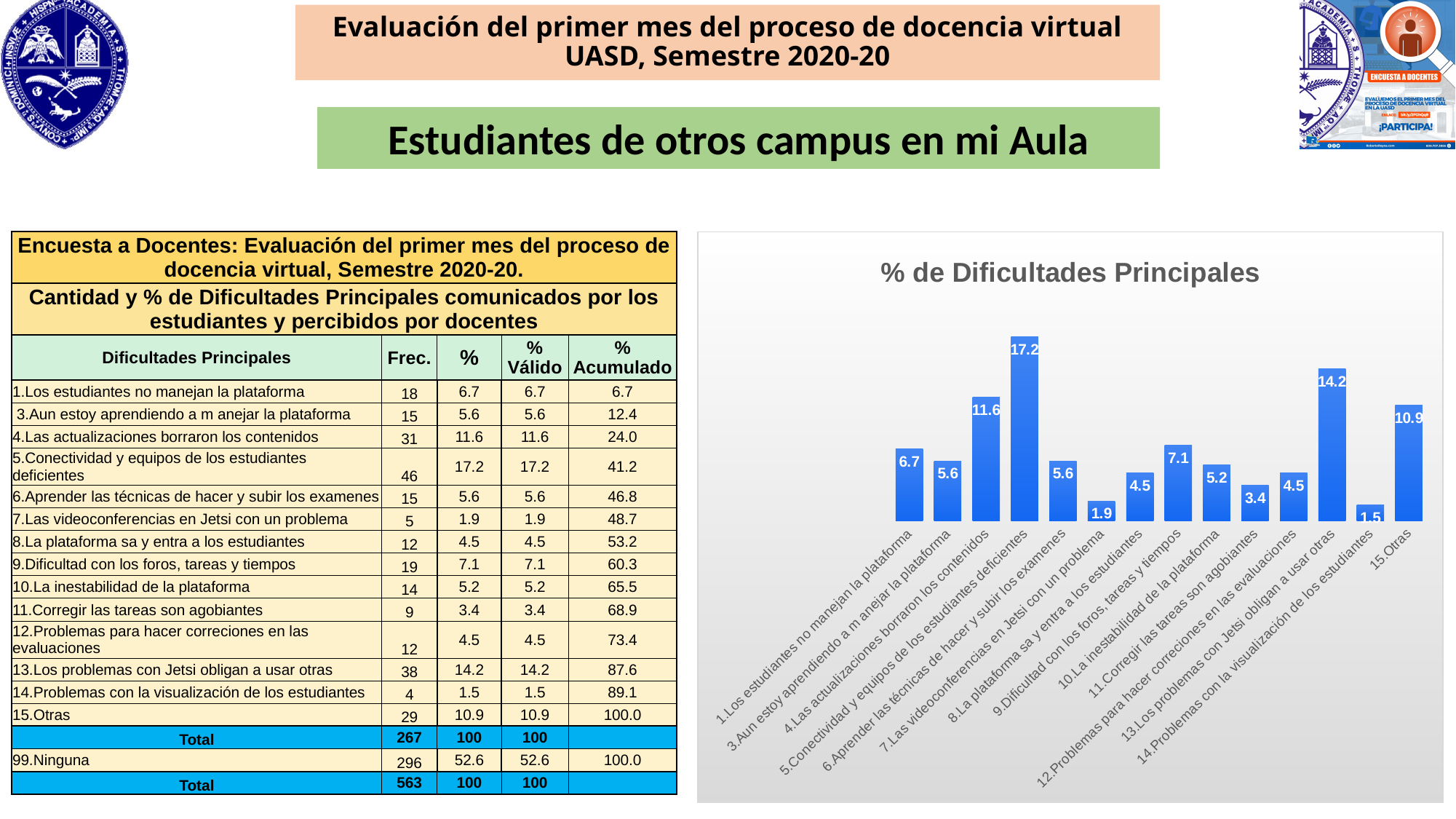
What is the title of the chart? % de Dificultades Principales What type of chart is shown on the slide? bar chart What is the value for '15.Otras' in the chart? 10.9 What is the value for '13.Los problemas con Jetsi obligan a usar otras' in the chart? 14.2 What is the difference between the values for '5.Conectividad y equipos de los estudiantes deficientes' and '13.Los problemas con Jetsi obligan a usar otras'? 3.0 Which category has the highest value in the chart? 5.Conectividad y equipos de los estudiantes deficientes Which is larger: the value for '4.Las actualizaciones borraron los contenidos' or the value for '15.Otras'? 4.Las actualizaciones borraron los contenidos How many bars does the chart have? 14 What is the difference between the values for '9.Dificultad con los foros, tareas y tiempos' and '11.Corregir las tareas son agobiantes'? 3.7 What is the value for '7.Las videoconferencias en Jetsi con un problema' in the chart? 1.9 Which category has the lowest value in the chart? 14.Problemas con la visualización de los estudiantes What is the value for '5.Conectividad y equipos de los estudiantes deficientes' in the chart? 17.2